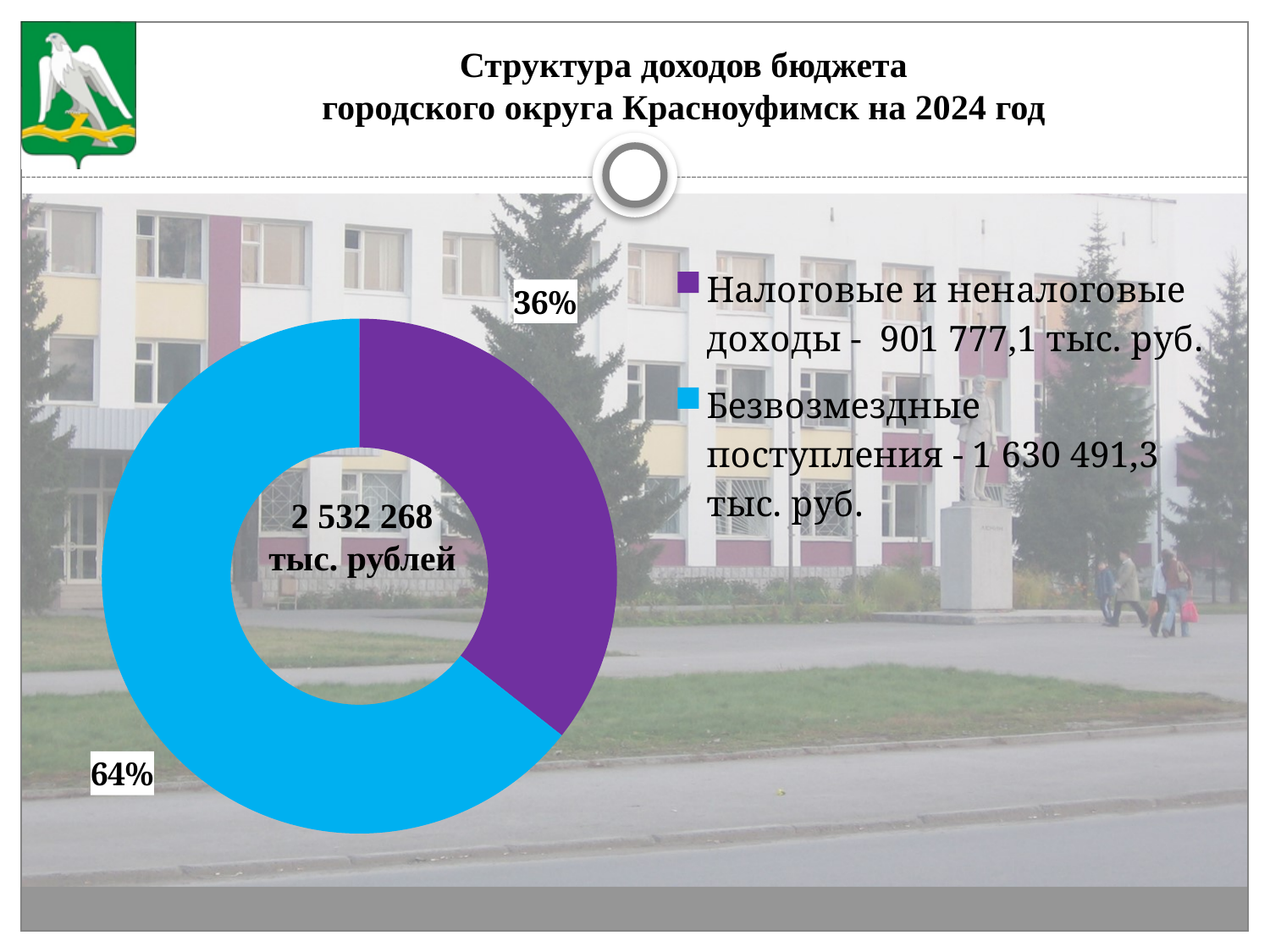
What colour represents Безвозмездные поступления in the chart? Blue What share of the budget revenue is shown for Налоговые и неналоговые доходы? 36% Which is larger: the share of Налоговые и неналоговые доходы or the share of Безвозмездные поступления? Безвозмездные поступления What share of the budget revenue is shown for Безвозмездные поступления? 64% What is the difference in percentage points between the shares of Безвозмездные поступления and Налоговые и неналоговые доходы? 28 Which category has the smallest share of the budget revenue? Налоговые и неналоговые доходы According to the legend, what is the amount of Налоговые и неналоговые доходы? 901 777,1 тыс. руб. Which category has the largest share of the budget revenue? Безвозмездные поступления How many categories does the chart show? 2 What total amount is printed in the centre of the chart? 2 532 268 тыс. рублей What kind of chart is shown on the slide? Doughnut (pie) chart According to the legend, what is the amount of Безвозмездные поступления? 1 630 491,3 тыс. руб.